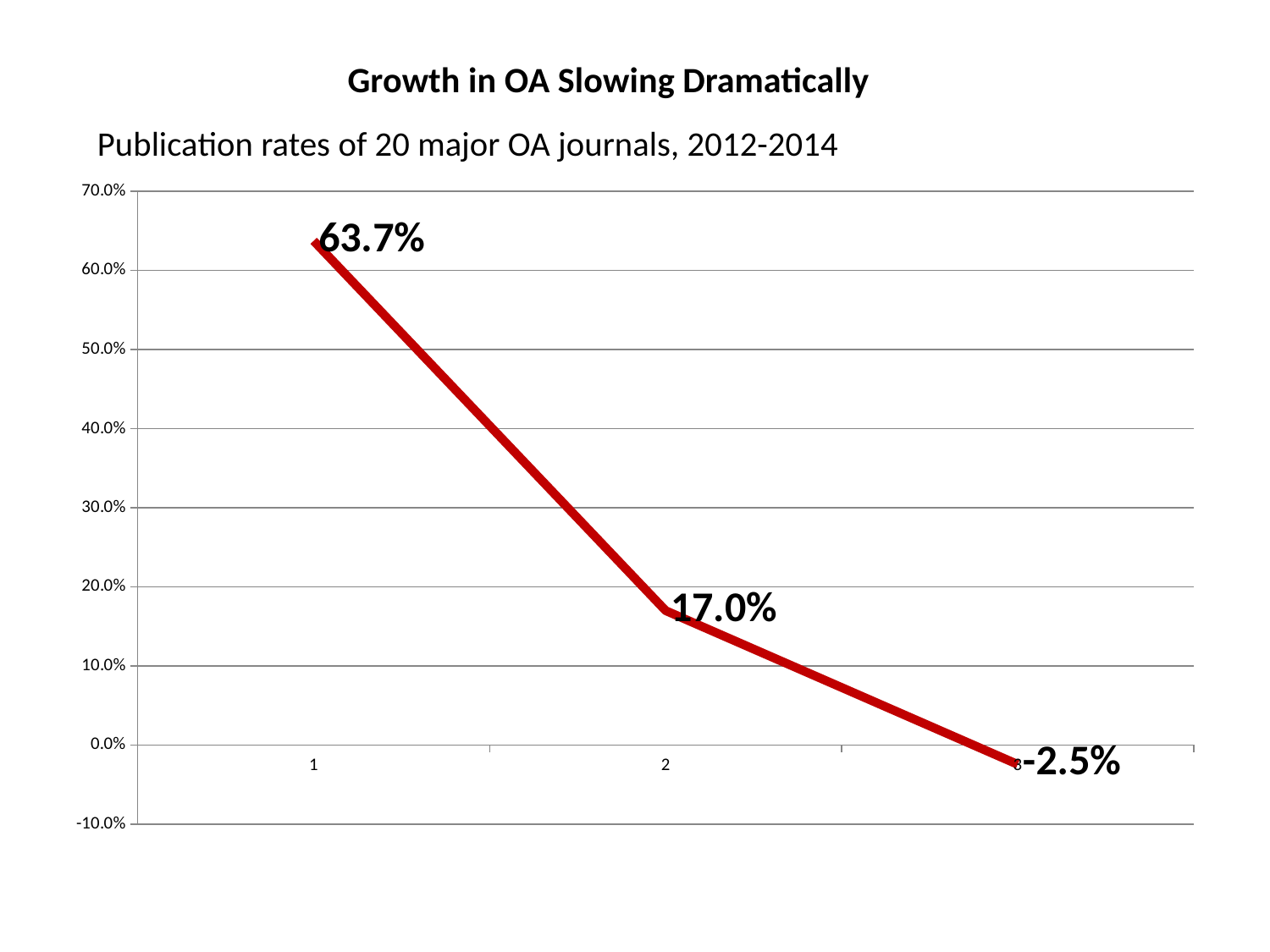
Which point has the lowest value? 3 Which point has the highest value? 1 Is the value at point 1 greater or less than 60.0%? greater What is the difference between the values at point 2 and point 3? 19.5% What is the value at point 3? -2.5% Which is larger, the value at point 2 or the value at point 3? point 2 Do the values rise or fall along the x axis? fall How many data points are plotted on the line? 3 What is the difference between the values at point 1 and point 2? 46.7% What is the value at point 2? 17.0% What is the value at point 1? 63.7% What type of chart is shown on the slide? line chart